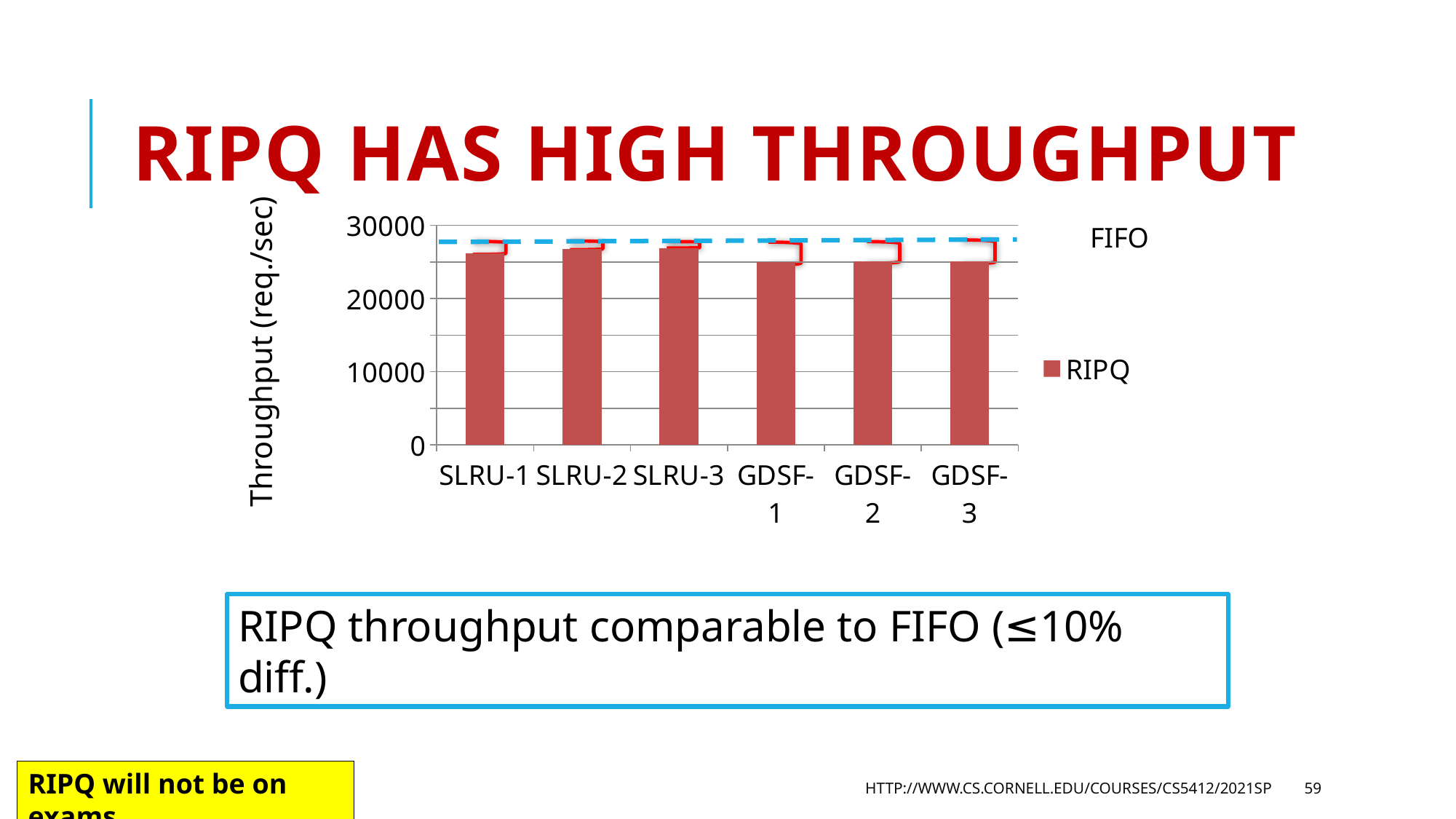
How many categories are shown on the x axis of the chart? 6 Is the RIPQ value for SLRU-1 greater or less than 20000? greater Is the RIPQ value for GDSF-1 greater or less than 10000? greater What is the label of the y axis of the chart? Throughput (req./sec) Which has the larger RIPQ throughput, SLRU-3 or GDSF-3? SLRU-3 What is the first category on the x axis of the chart? SLRU-1 Is the RIPQ value for GDSF-3 greater or less than 20000? greater What is the highest tick value shown on the y axis of the chart? 30000 What kind of chart is shown on the slide? bar chart Which series is listed in the chart's legend with a colour marker? RIPQ